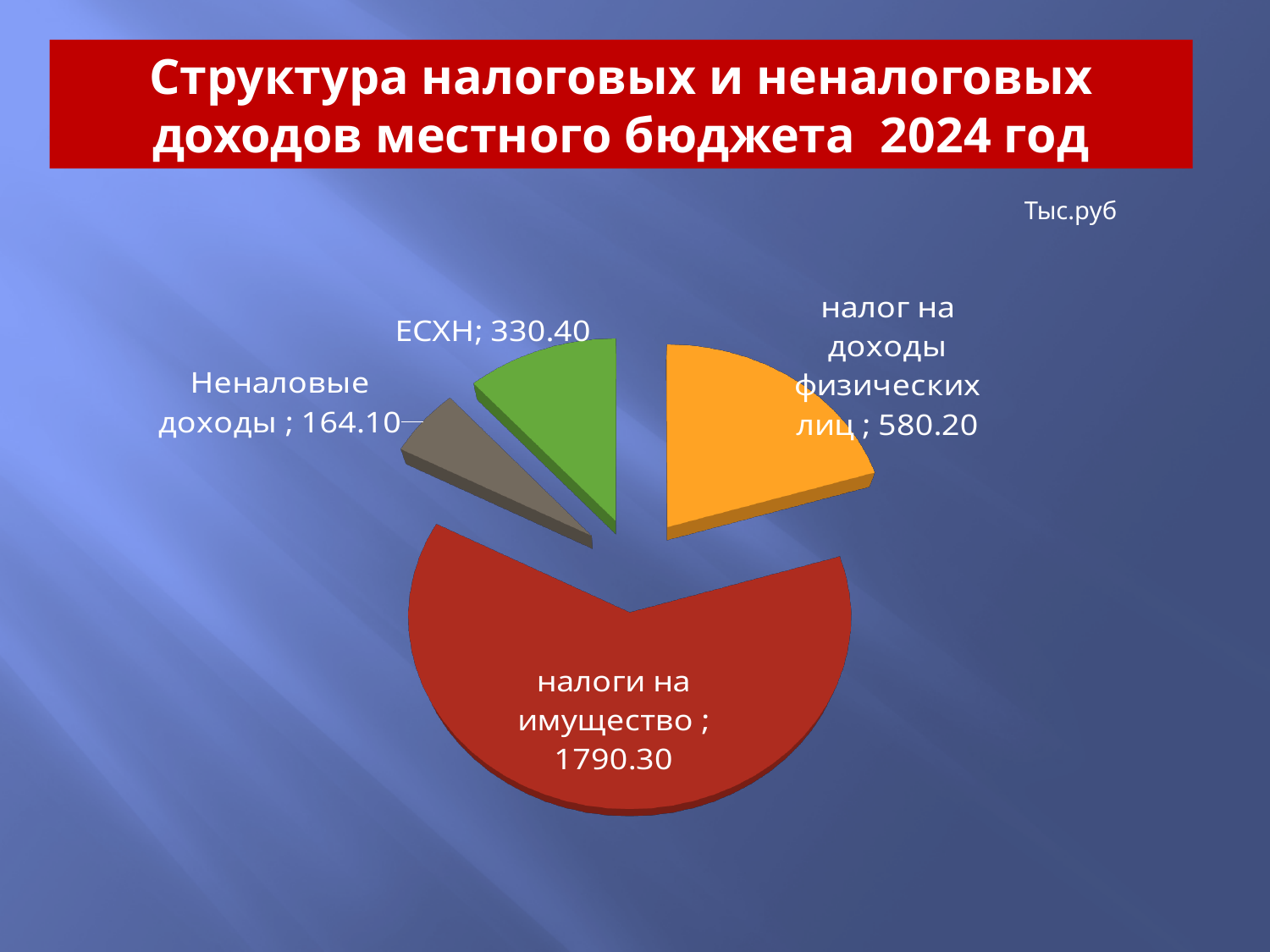
How many slices does the pie chart have? 4 What is the difference between налоги на имущество and налог на доходы физических лиц? 1210.10 What is the value for налоги на имущество? 1790.30 Which is larger, ЕСХН or налог на доходы физических лиц? налог на доходы физических лиц What unit of measurement is indicated on the slide for the chart values? Тыс.руб What is the difference between ЕСХН and Неналовые доходы? 166.30 What is the value for Неналовые доходы? 164.10 What is the value for налог на доходы физических лиц? 580.20 Which category has the smallest slice of the pie? Неналовые доходы Which category has the largest slice of the pie? налоги на имущество What is the value for ЕСХН? 330.40 What type of chart is shown on the slide? Pie chart